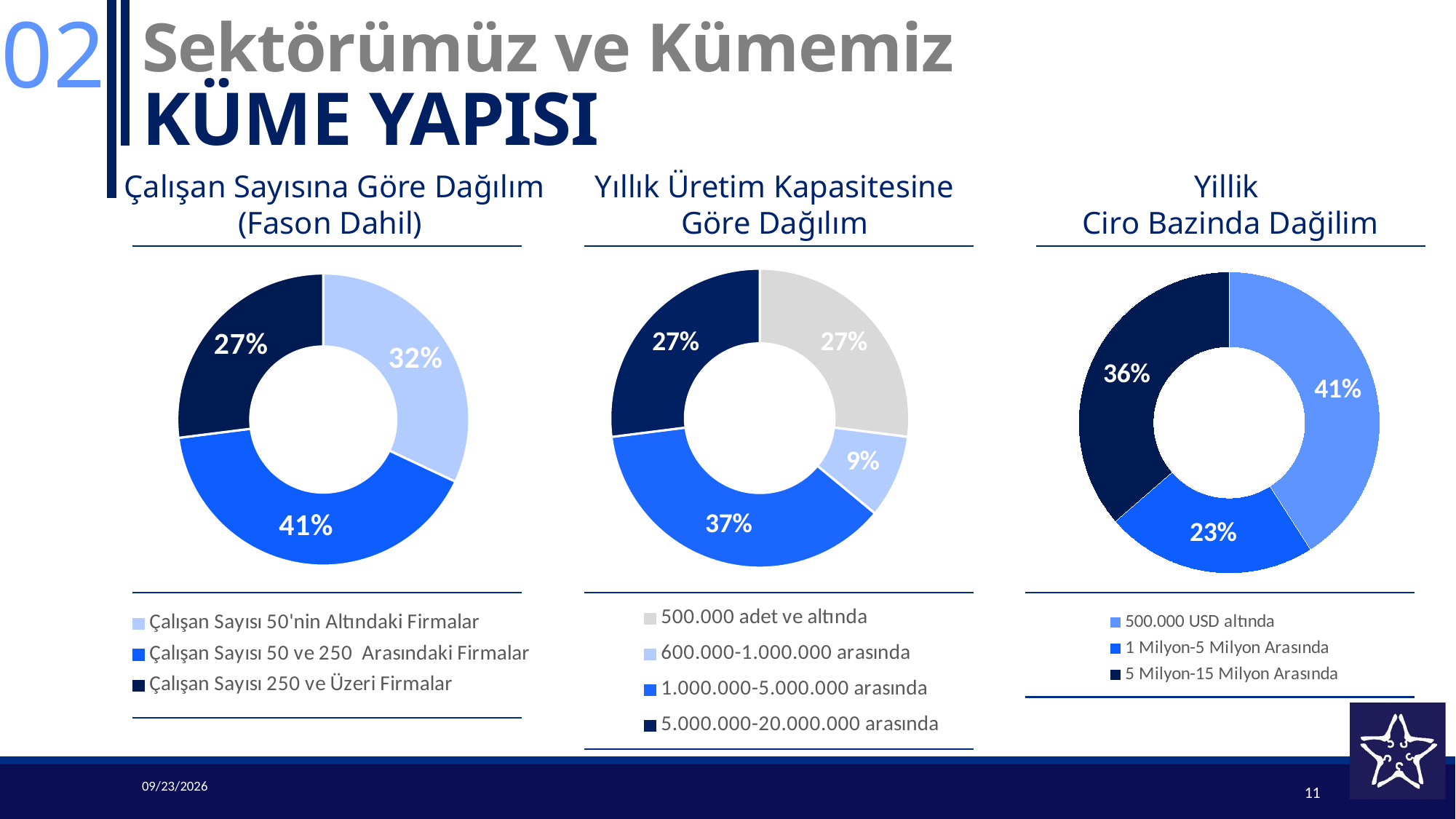
How many categories does the 'Yıllık Üretim Kapasitesine Göre Dağılım' chart show? 4 In the 'Yıllık Üretim Kapasitesine Göre Dağılım' chart, what share is shown for '600.000-1.000.000 arasında'? 9% In the 'Yillik Ciro Bazinda Dağilim' chart, which is larger: the share for '500.000 USD altında' or the share for '5 Milyon-15 Milyon Arasında'? 500.000 USD altında In the 'Çalışan Sayısına Göre Dağılım (Fason Dahil)' chart, what is the difference between the shares for 'Çalışan Sayısı 50'nin Altındaki Firmalar' and 'Çalışan Sayısı 250 ve Üzeri Firmalar'? 5% In the 'Yıllık Üretim Kapasitesine Göre Dağılım' chart, which category has the largest share? 1.000.000-5.000.000 arasında In the 'Yillik Ciro Bazinda Dağilim' chart, what share is shown for '1 Milyon-5 Milyon Arasında'? 23% In the 'Çalışan Sayısına Göre Dağılım (Fason Dahil)' chart, which category has the smallest share? Çalışan Sayısı 250 ve Üzeri Firmalar In the 'Çalışan Sayısına Göre Dağılım (Fason Dahil)' chart, what share is shown for 'Çalışan Sayısı 50 ve 250 Arasındaki Firmalar'? 41% What type of chart is the 'Yillik Ciro Bazinda Dağilim' chart? Donut (pie) chart How many entries does the legend of the 'Çalışan Sayısına Göre Dağılım (Fason Dahil)' chart list? 3 In the 'Yillik Ciro Bazinda Dağilim' chart, what is the difference between the shares for '5 Milyon-15 Milyon Arasında' and '1 Milyon-5 Milyon Arasında'? 13% In the 'Yıllık Üretim Kapasitesine Göre Dağılım' chart, what share is shown for '5.000.000-20.000.000 arasında'? 27%